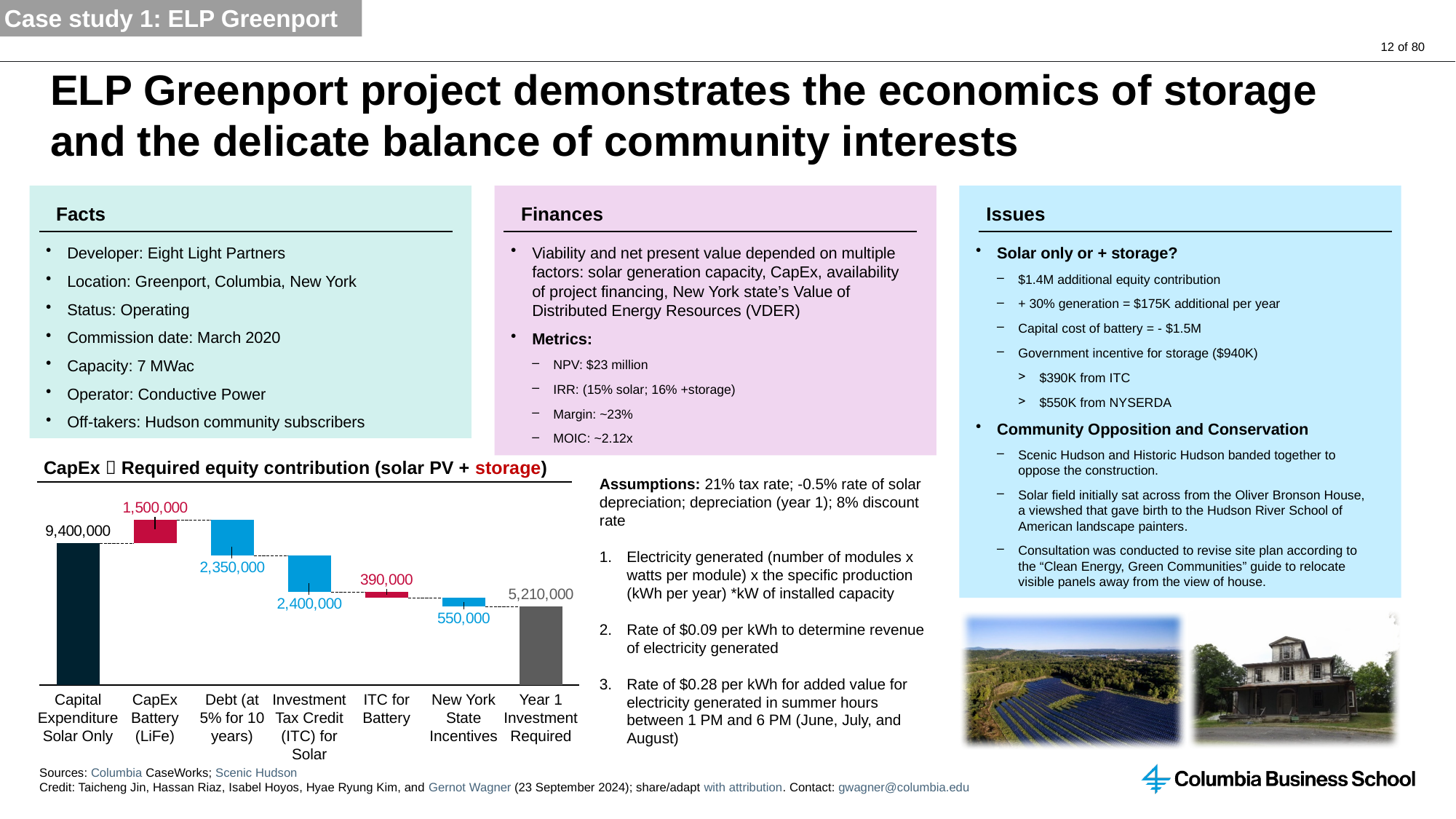
What is the Year 1 Investment Required shown in the chart? 5,210,000 What is the value shown for Debt (at 5% for 10 years)? 2,350,000 What is the value shown for New York State Incentives? 550,000 What kind of chart is used to show the CapEx to required equity contribution? Bar chart (waterfall) What is the value shown for ITC for Battery? 390,000 Which category in the chart has the smallest value? ITC for Battery What is the value shown for CapEx Battery (LiFe)? 1,500,000 What is the value shown for Investment Tax Credit (ITC) for Solar? 2,400,000 What is the difference between the Capital Expenditure Solar Only value and the Year 1 Investment Required value? 4,190,000 Which category in the chart has the largest value? Capital Expenditure Solar Only How many categories are shown along the x axis of the chart? 7 What is the value for Capital Expenditure Solar Only in the CapEx to required equity contribution chart? 9,400,000